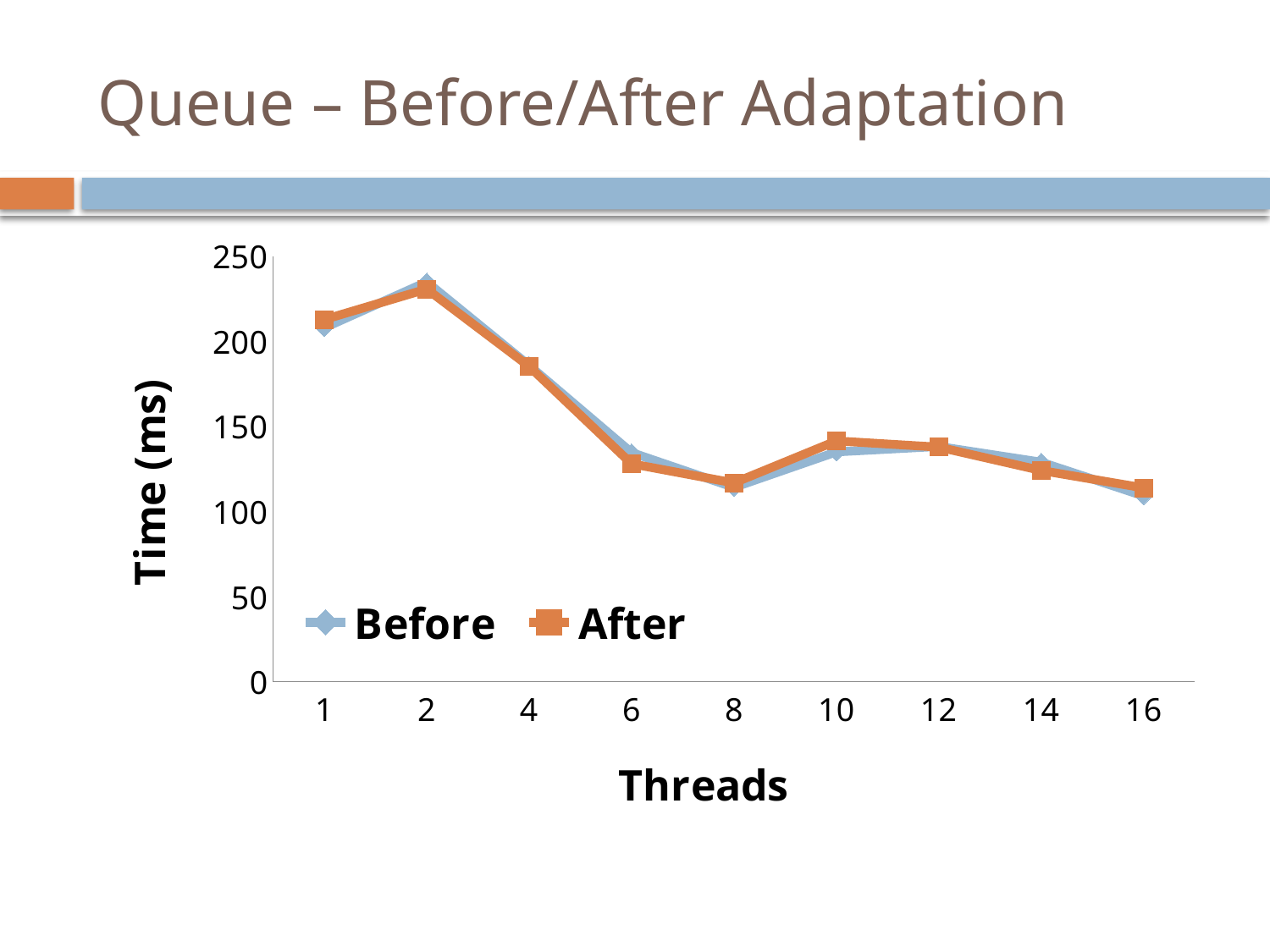
How many series does the legend list? 2 Is the value for After at 4 threads greater or less than 150? greater At which number of threads does the Before series reach its highest value? 2 Is the value for Before at 16 threads greater or less than 150? less Is the value for After at 2 threads greater or less than 200? greater How many thread counts are plotted along the x axis? 9 What kind of chart is shown on the slide? Line chart At which number of threads does the After series reach its highest value? 2 Does the Before series rise or fall between 2 and 8 threads? Fall What is the label of the y axis? Time (ms) What are the two entries in the legend? Before and After